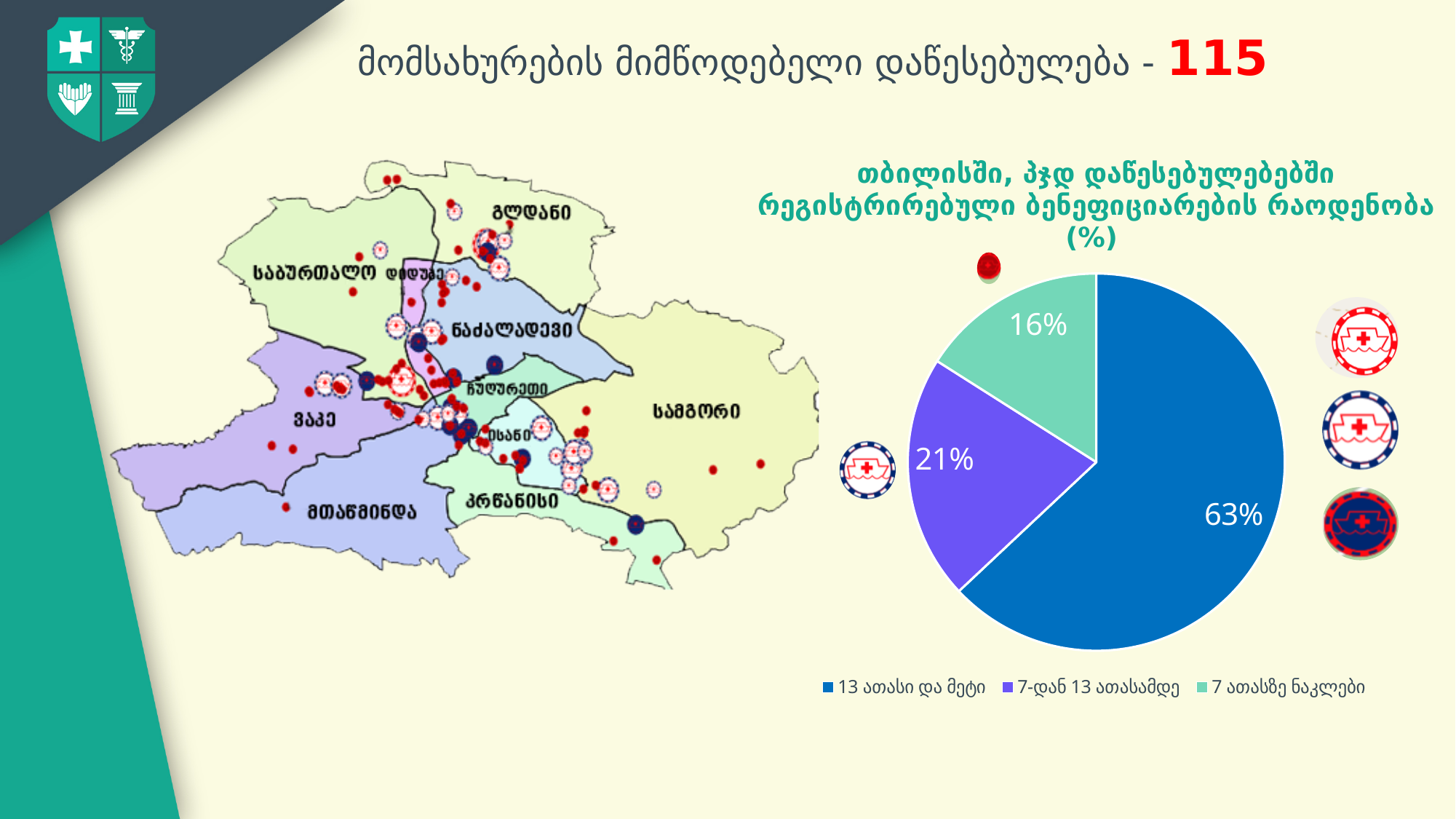
What is the difference in percentage points between the "7-დან 13 ათასამდე" slice and the "7 ათასზე ნაკლები" slice? 5 What share of the pie does the "13 ათასი და მეტი" slice represent? 63% What is the difference in percentage points between the "13 ათასი და მეტი" slice and the "7-დან 13 ათასამდე" slice? 42 Which slice is larger: "7-დან 13 ათასამდე" or "7 ათასზე ნაკლები"? 7-დან 13 ათასამდე Which category has the largest slice in the pie chart? 13 ათასი და მეტი What share of the pie does the "7-დან 13 ათასამდე" slice represent? 21% How many slices does the pie chart have? 3 What colour is the "13 ათასი და მეტი" slice in the pie chart? Blue Which category has the smallest slice in the pie chart? 7 ათასზე ნაკლები How many entries does the pie chart legend list? 3 What kind of chart is shown on the right side of the slide? Pie chart What share of the pie does the "7 ათასზე ნაკლები" slice represent? 16%